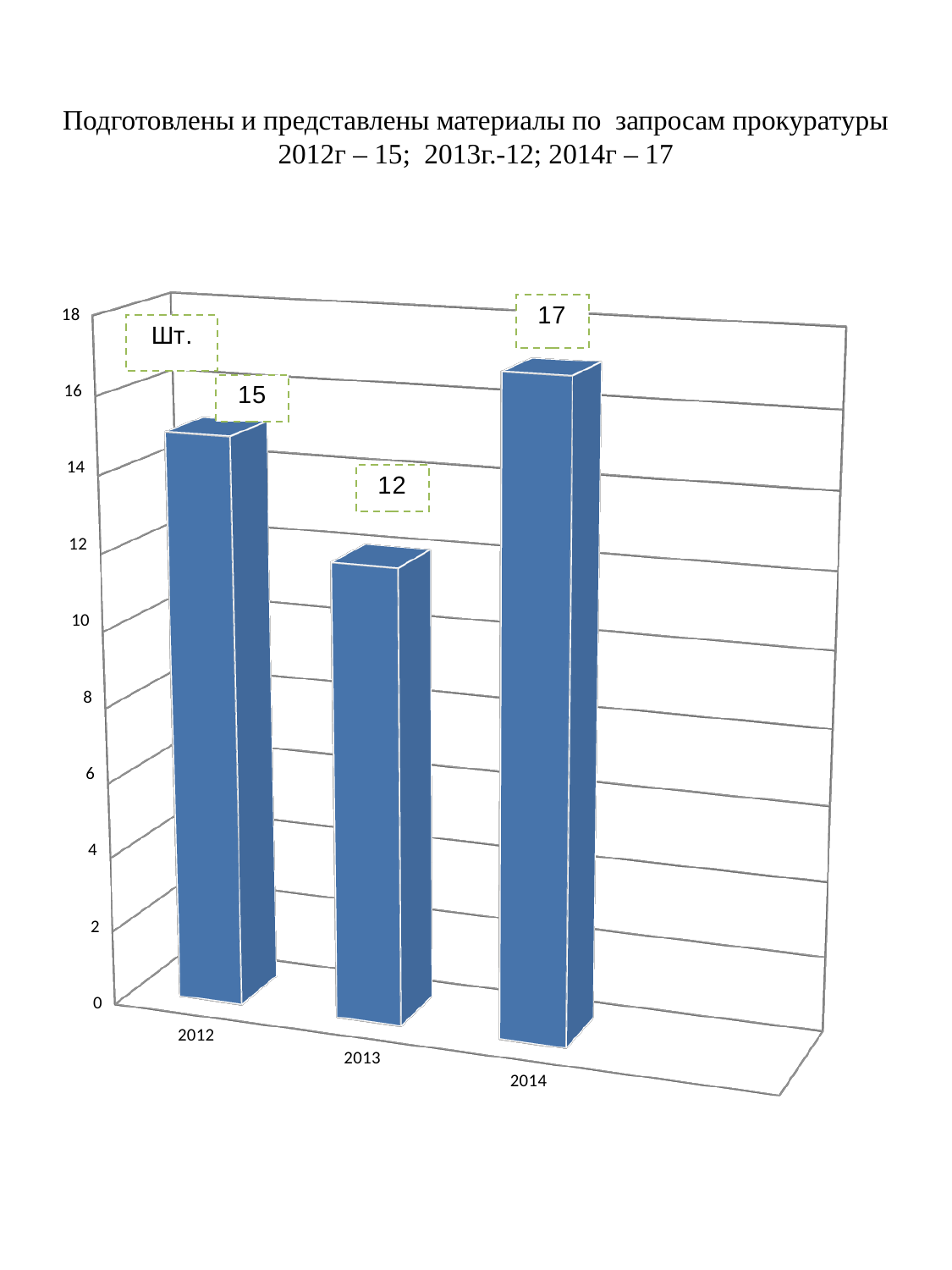
Is the value for 2013 greater or less than 14? less What is the value for 2013? 12 Which is larger, the value for 2012 or the value for 2014? 2014 Which year has the highest value? 2014 Which year has the lowest value? 2013 What unit label is shown in the box at the top left of the chart? Шт. How many years are shown on the chart? 3 What is the difference between the values for 2014 and 2013? 5 What is the value for 2014? 17 What is the value for 2012? 15 What kind of chart is shown on the slide? bar chart What is the difference between the values for 2012 and 2013? 3